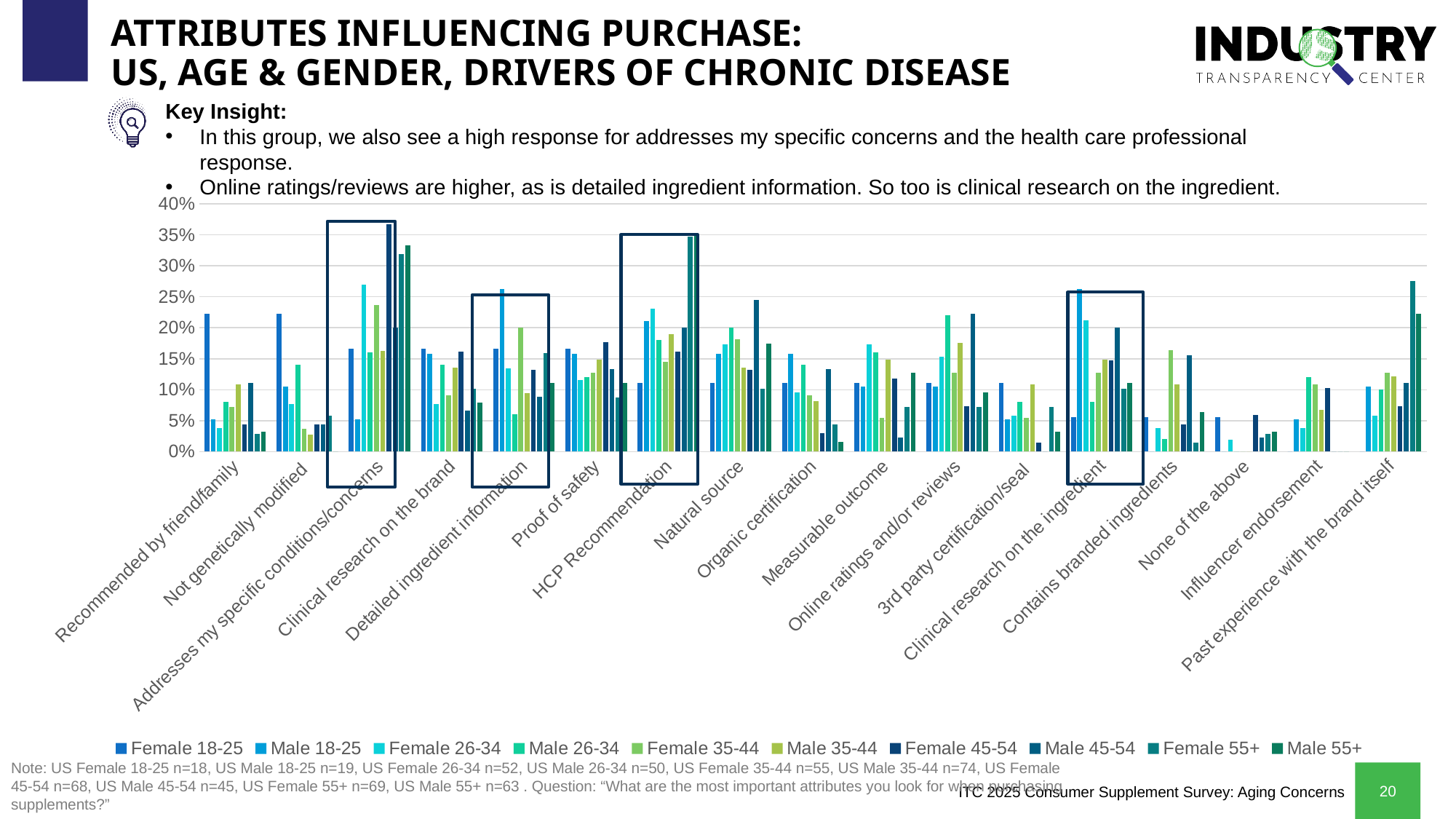
Is the value for Female 45-54 on 'Measurable outcome' greater or less than 20%? less Is the value for Male 55+ on 'Past experience with the brand itself' greater or less than 25%? less Is the value for Female 55+ on 'Addresses my specific conditions/concerns' greater or less than 30%? greater What kind of chart is shown on the slide? bar chart How many attribute categories are shown along the x axis of the chart? 17 What is the highest value shown on the chart's y axis? 40% How many categories on the chart are outlined with a highlight box? 4 How many series does the chart's legend list? 10